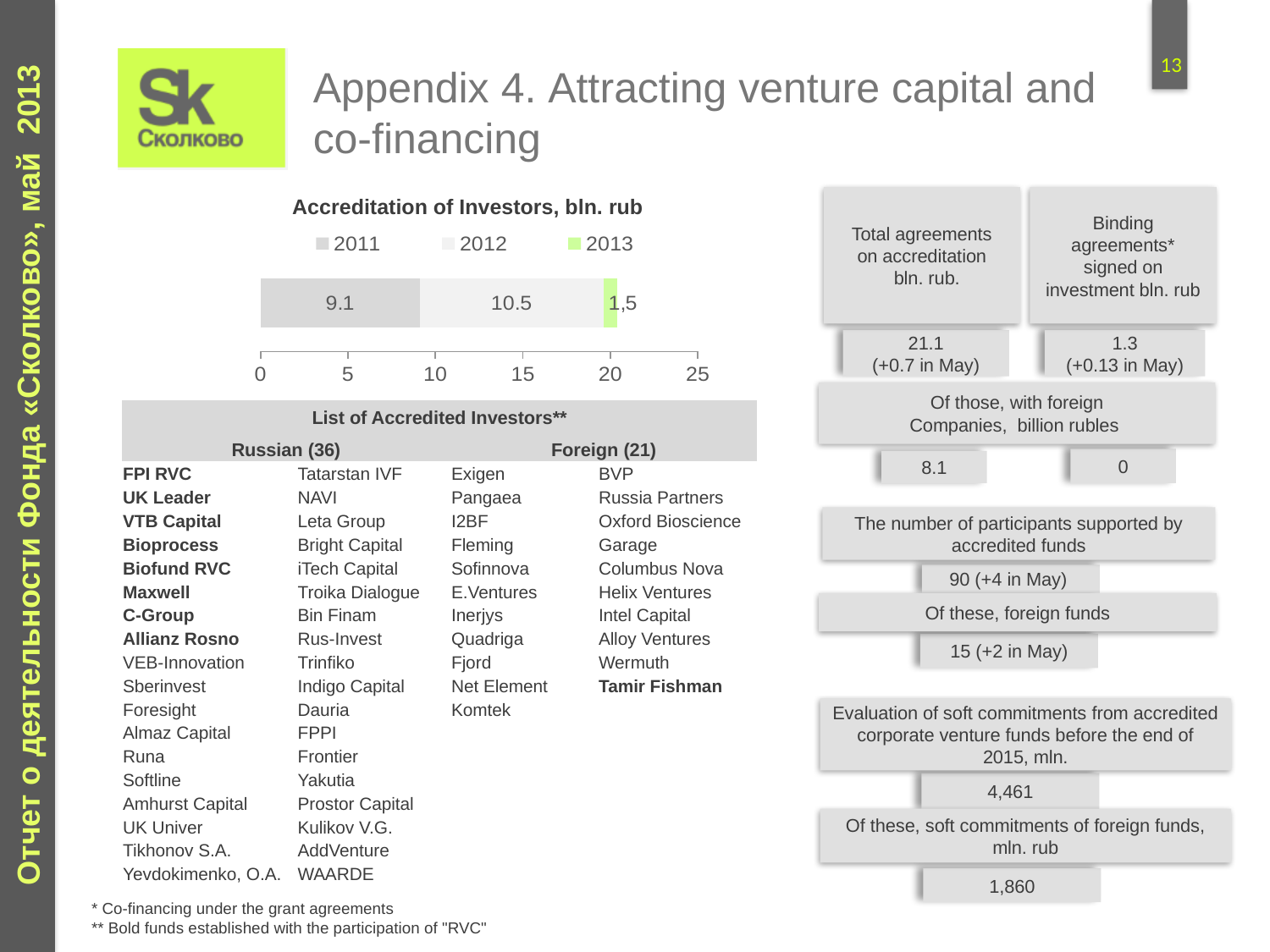
In the 'Accreditation of Investors, bln. rub' chart, what is the maximum value shown on the horizontal axis? 25 In the 'Accreditation of Investors, bln. rub' chart, what is the value for 2013? 1,5 In the 'Accreditation of Investors, bln. rub' chart, what is the total of the stacked bar across all three years? 21.1 In the 'Accreditation of Investors, bln. rub' chart, what is the value for 2012? 10.5 In the 'Accreditation of Investors, bln. rub' chart, which year has the lowest value? 2013 In the 'Accreditation of Investors, bln. rub' chart, which is larger, the value for 2011 or the value for 2013? 2011 How many series does the legend of the 'Accreditation of Investors, bln. rub' chart list? 3 In the 'Accreditation of Investors, bln. rub' chart, which year has the highest value? 2012 In the 'Accreditation of Investors, bln. rub' chart, what is the difference between the 2012 and 2011 values? 1.4 In the 'Accreditation of Investors, bln. rub' chart, what is the value for 2011? 9.1 What kind of chart is 'Accreditation of Investors, bln. rub'? Stacked bar chart In the 'Accreditation of Investors, bln. rub' chart, which year's segment is shown in green? 2013